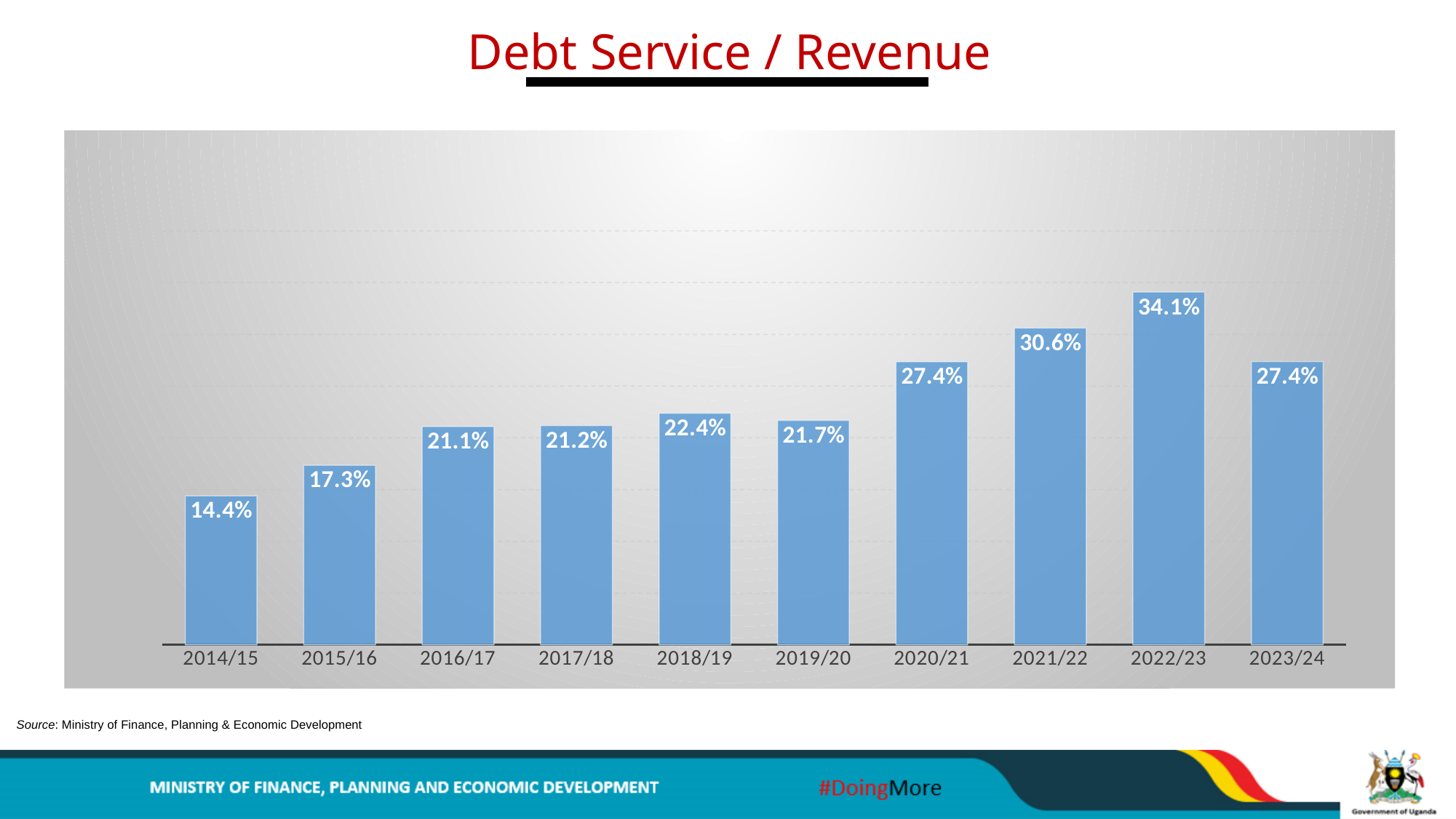
What kind of chart is shown on the slide? Bar chart Which year has the lowest Debt Service / Revenue value? 2014/15 What is the Debt Service / Revenue value for 2018/19? 22.4% Does the Debt Service / Revenue value rise or fall from 2014/15 to 2022/23? Rise What is the Debt Service / Revenue value for 2014/15? 14.4% How many years are shown on the x axis of the chart? 10 What is the difference between the Debt Service / Revenue values for 2022/23 and 2023/24? 6.7% What is the title of the chart? Debt Service / Revenue Which is larger, the Debt Service / Revenue value for 2019/20 or for 2018/19? 2018/19 What is the difference between the Debt Service / Revenue values for 2015/16 and 2014/15? 2.9% Which year has the highest Debt Service / Revenue value? 2022/23 What is the Debt Service / Revenue value for 2021/22? 30.6%